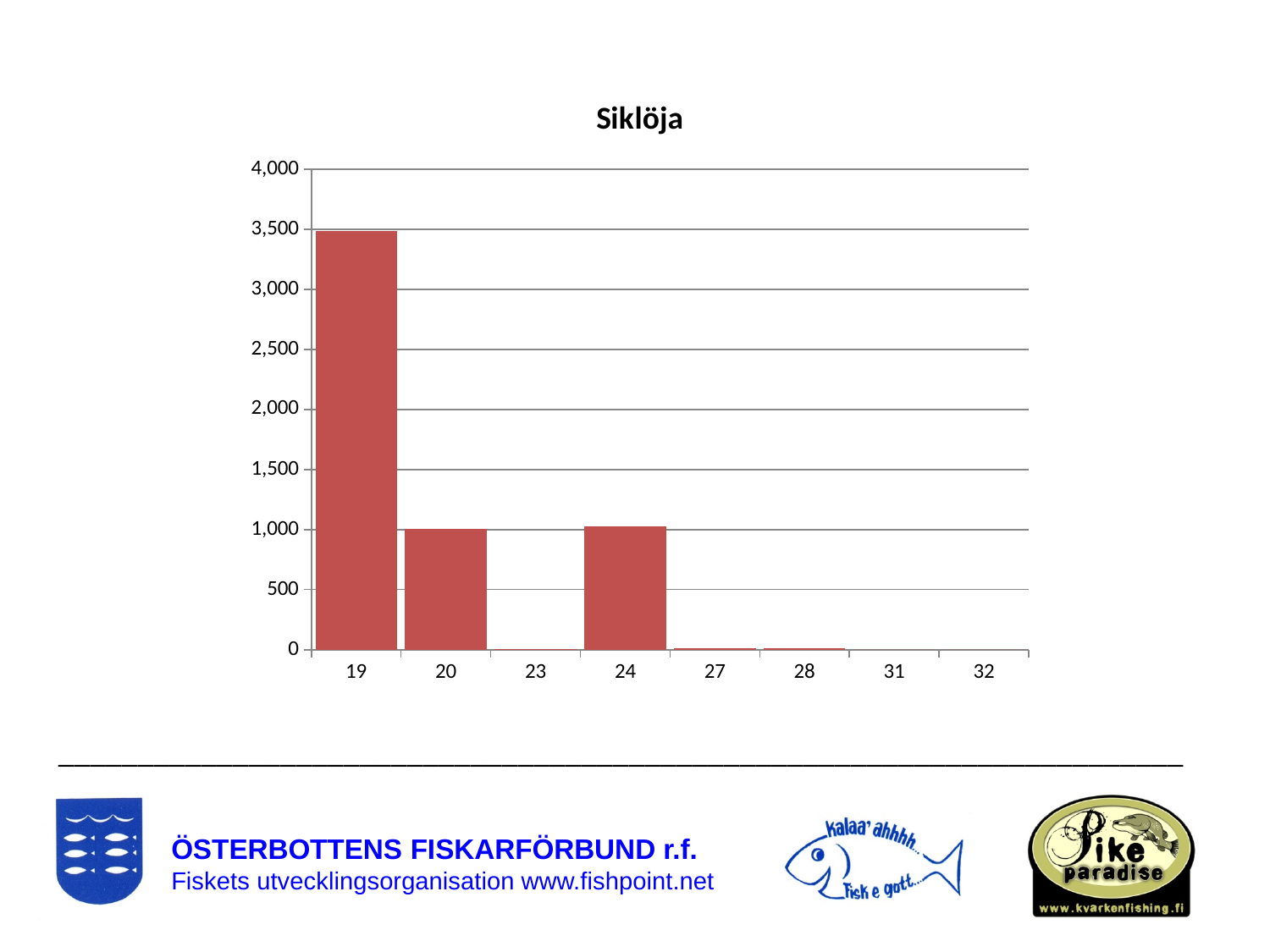
What colour are the bars in the chart? red Is the value for category 24 greater or less than 500? greater What kind of chart is shown on the slide? bar chart Which has the larger value, category 19 or category 20? 19 Is the value for category 24 greater or less than 1,500? less Which category has the highest value in the chart? 19 Is the value for category 20 greater or less than 1,500? less How many categories are shown on the x axis of the chart? 8 What is the title of the chart? Siklöja Which has the larger value, category 24 or category 27? 24